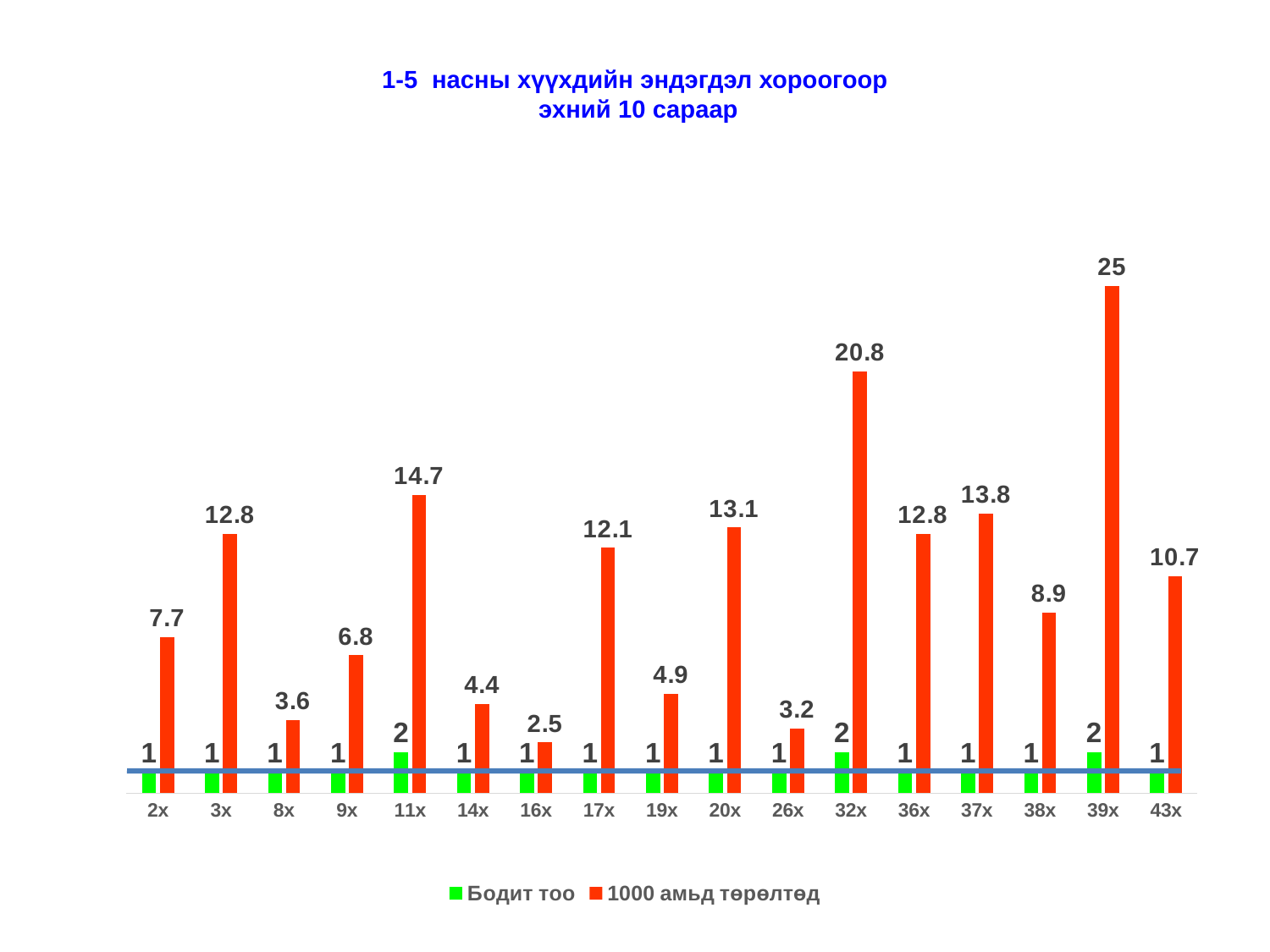
What is the difference between the '1000 амьд төрөлтөд' values for 39х and 32х? 4.2 What is the value of the '1000 амьд төрөлтөд' series for 11х? 14.7 Which category has the highest value in the '1000 амьд төрөлтөд' series? 39х What is the difference between the '1000 амьд төрөлтөд' values for 3х and 8х? 9.2 Which category has the lowest value in the '1000 амьд төрөлтөд' series? 16х How many series does the legend list? 2 How many categories are shown on the x axis? 17 What kind of chart is shown on the slide? Bar chart Which colour represents the 'Бодит тоо' series? Green What is the value of the 'Бодит тоо' series for 32х? 2 What is the value of the '1000 амьд төрөлтөд' series for 39х? 25 Which has a larger '1000 амьд төрөлтөд' value, 20х or 37х? 37х